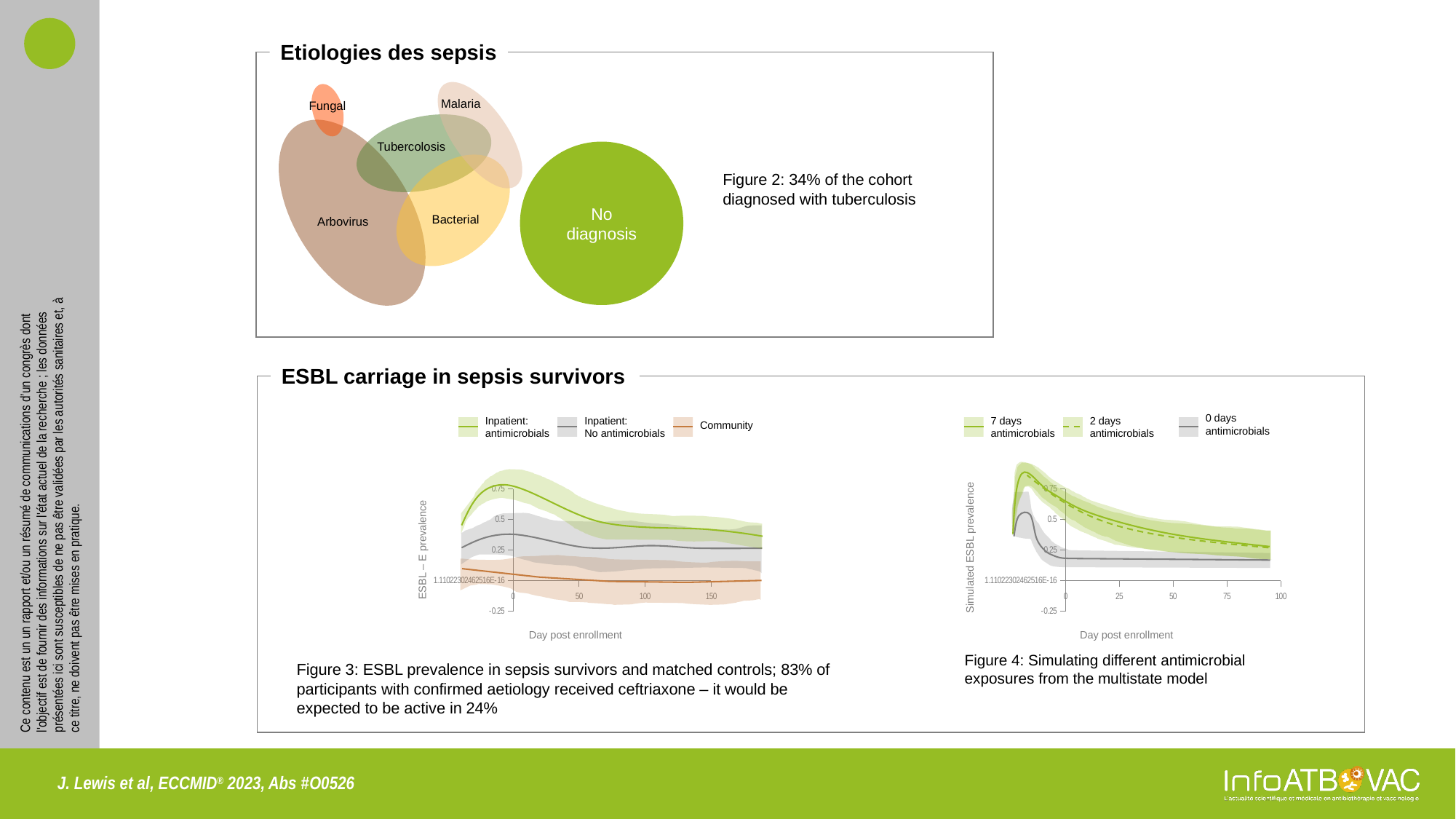
In Figure 3, which is higher at day 100: Inpatient: antimicrobials or Inpatient: No antimicrobials? Inpatient: antimicrobials How many series does the legend of Figure 3 list? 3 In Figure 3, is the ESBL prevalence for Community at day 50 greater or less than 0.25? less In Figure 3, which series has the highest ESBL prevalence at day 0? Inpatient: antimicrobials In Figure 4, which series is drawn with a dashed line? 2 days antimicrobials What kind of chart is Figure 3 (ESBL prevalence in sepsis survivors)? line chart In Figure 3, is the ESBL prevalence for Inpatient: antimicrobials at day 0 greater or less than 0.5? greater In Figure 3, which series has the lowest ESBL prevalence across the days shown? Community What is the x-axis label of Figure 4? Day post enrollment How many series does the legend of Figure 4 list? 3 In Figure 4, is the simulated ESBL prevalence for 0 days antimicrobials at day 50 greater or less than 0.25? less In Figure 3, does the Inpatient: antimicrobials line rise or fall between day 0 and day 150? fall